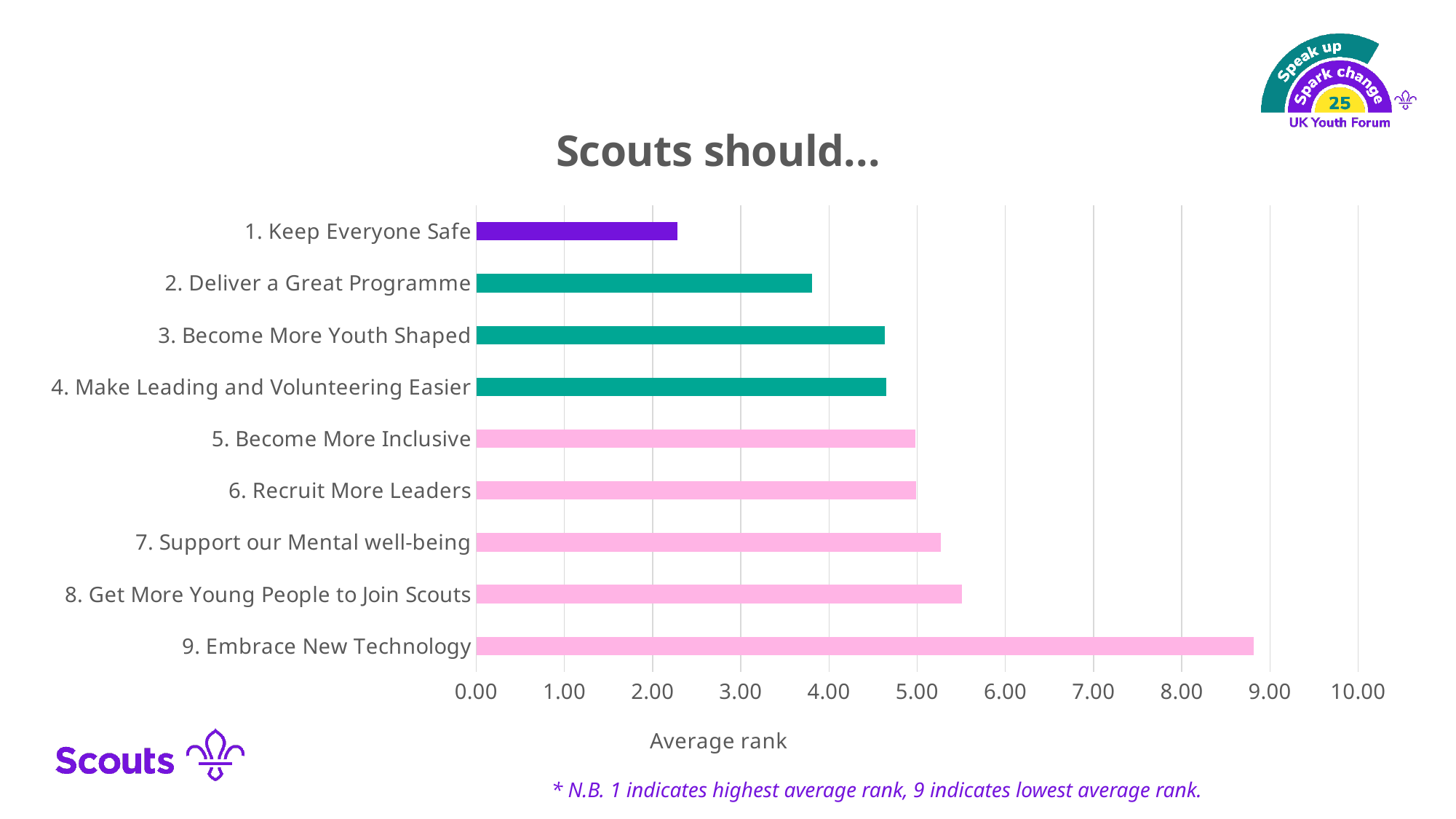
What kind of chart is shown on the slide? bar chart What is the label on the horizontal axis of the chart? Average rank Is the value for 1. Keep Everyone Safe greater or less than 3.00? less Is the value for 9. Embrace New Technology greater or less than 8.00? greater How many categories are plotted in the chart? 9 What is the title of the chart? Scouts should... Is the value for 2. Deliver a Great Programme greater or less than 4.00? less Which category has the lowest average rank value (shortest bar)? 1. Keep Everyone Safe Which category has the highest average rank value (longest bar)? 9. Embrace New Technology Which has the larger value: 2. Deliver a Great Programme or 8. Get More Young People to Join Scouts? 8. Get More Young People to Join Scouts